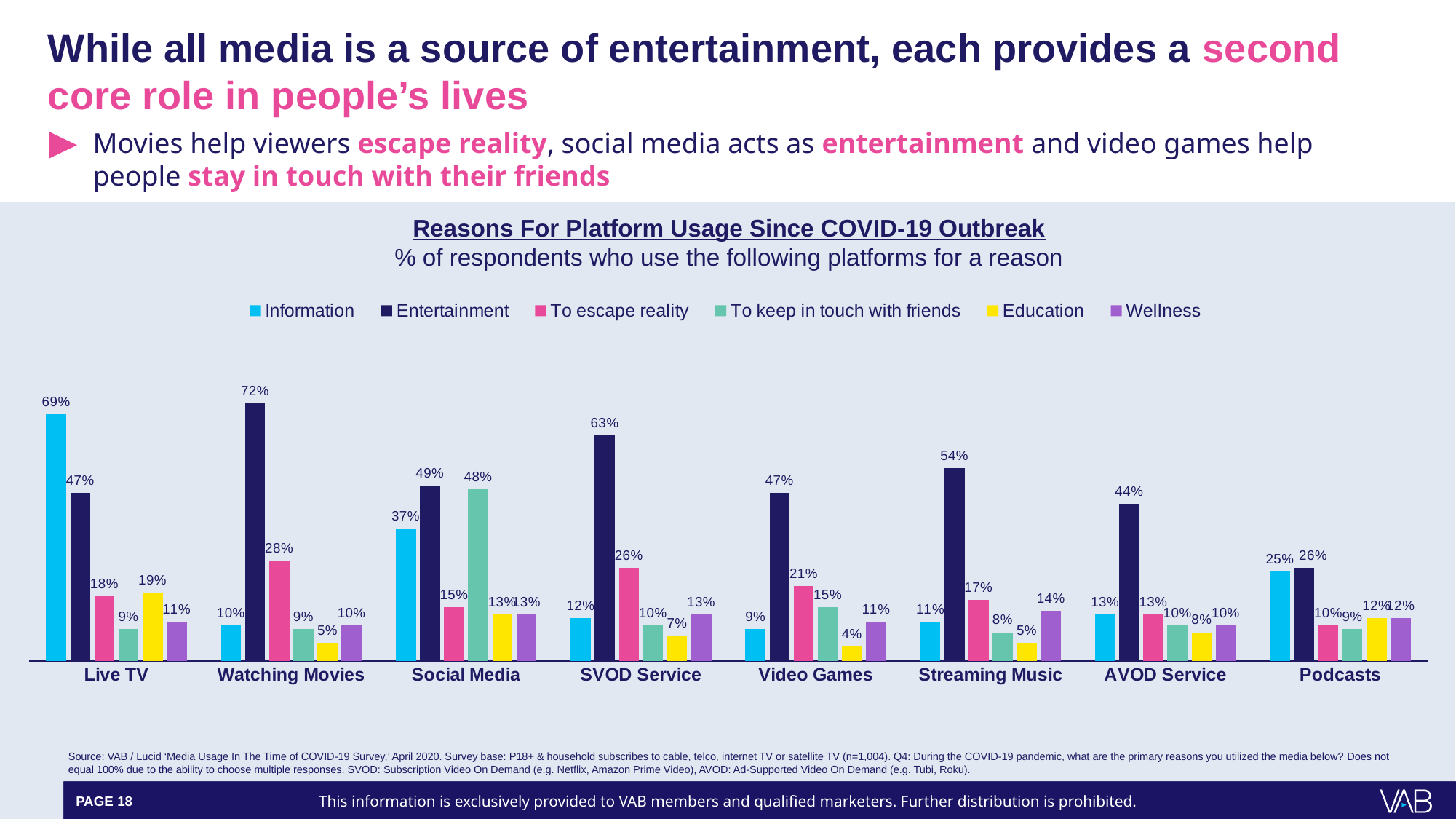
What is the title of the chart? Reasons For Platform Usage Since COVID-19 Outbreak What kind of chart is shown on the slide? Bar chart What percentage of respondents use Social Media to keep in touch with friends? 48% What is the difference between the Entertainment value for SVOD Service and the Entertainment value for AVOD Service? 19% What percentage of respondents use Watching Movies for Entertainment? 72% What percentage of respondents use Video Games to escape reality? 21% How many platforms are shown on the x axis of the chart? 8 What percentage of respondents use Live TV for Information? 69% How many series does the legend list? 6 Which platform has the lowest Education value? Video Games Which is larger: the Information value for Live TV or the Information value for Social Media? Live TV Which platform has the highest Entertainment value? Watching Movies